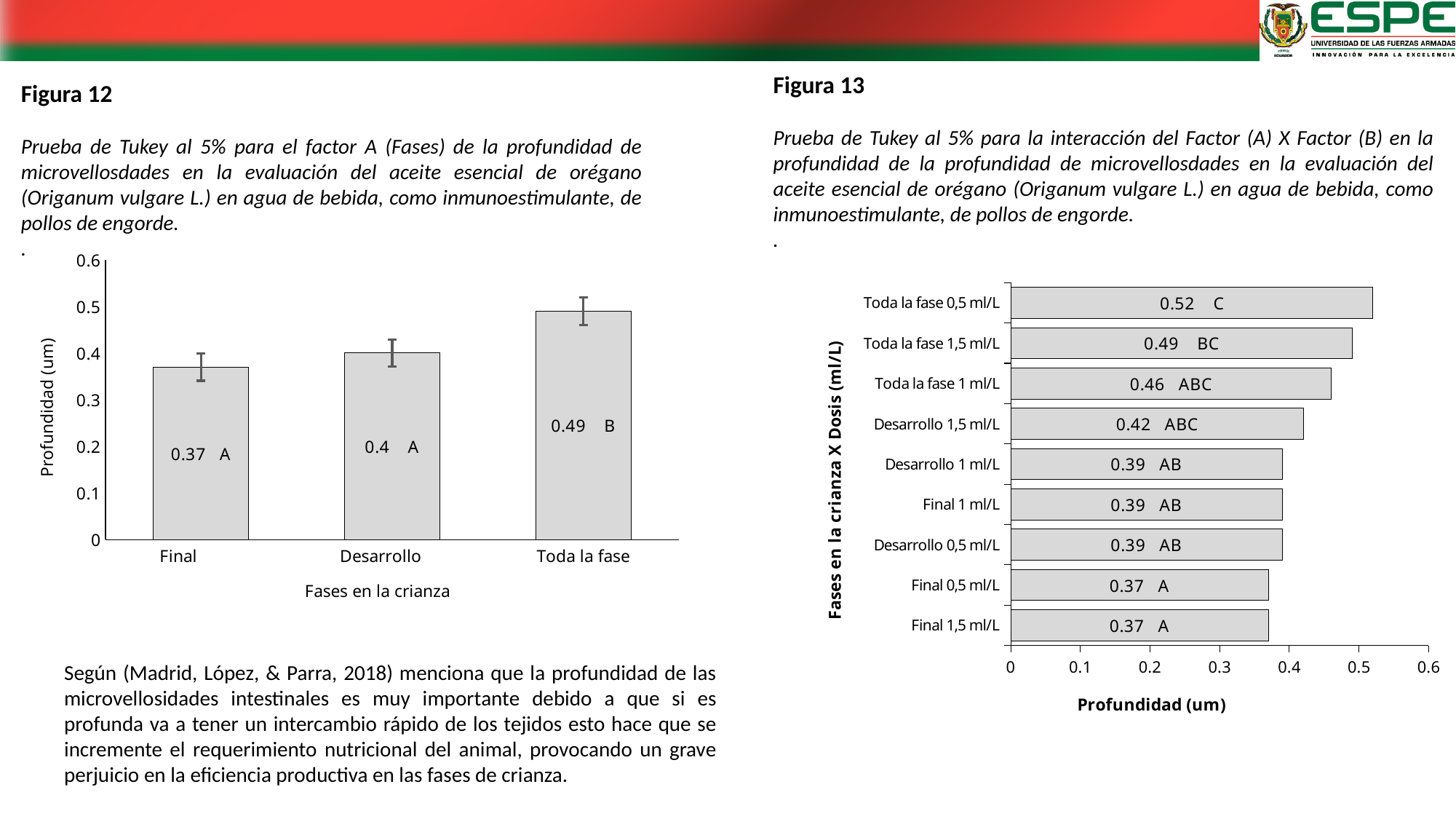
In the Figura 12 chart on the left, how many phases are plotted? 3 In the Figura 13 chart on the right, how many categories are plotted? 9 In the Figura 13 chart on the right, what is the value for Toda la fase 0,5 ml/L? 0.52 In the Figura 12 chart on the left, what is the difference between Toda la fase and Final? 0.12 In the Figura 12 chart on the left, which phase has the highest profundidad? Toda la fase In the Figura 12 chart on the left, what type of chart is shown? Bar chart In the Figura 12 chart on the left, what is the value for Toda la fase? 0.49 In the Figura 13 chart on the right, what is the label of the horizontal axis? Profundidad (um) In the Figura 12 chart on the left, which phase has the lowest profundidad? Final In the Figura 13 chart on the right, which category has the highest profundidad? Toda la fase 0,5 ml/L In the Figura 13 chart on the right, what is the value for Desarrollo 1,5 ml/L? 0.42 In the Figura 12 chart on the left, what is the value for Final? 0.37